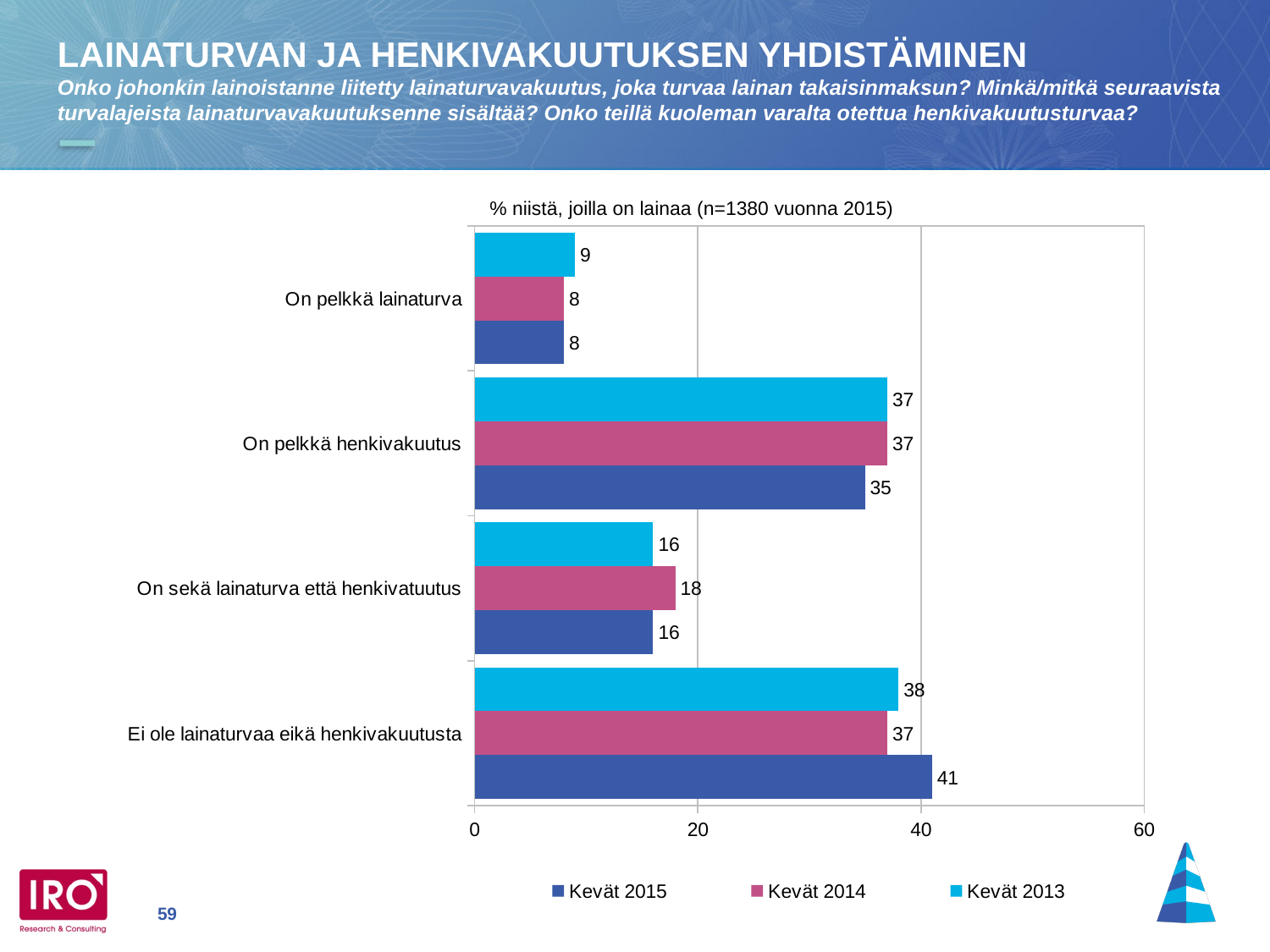
Is the Kevät 2015 value for 'On pelkkä henkivakuutus' greater or less than 20? greater Which category has the highest value for Kevät 2015? Ei ole lainaturvaa eikä henkivakuutusta What is the subtitle printed above the chart? % niistä, joilla on lainaa (n=1380 vuonna 2015) What kind of chart is shown on the slide? bar chart What is the value for Kevät 2015 in the category 'Ei ole lainaturvaa eikä henkivakuutusta'? 41 Which category has the lowest value for Kevät 2014? On pelkkä lainaturva How many categories are shown on the chart? 4 What is the value for Kevät 2014 in the category 'On sekä lainaturva että henkivatuutus'? 18 What is the difference between the Kevät 2015 and Kevät 2014 values for 'Ei ole lainaturvaa eikä henkivakuutusta'? 4 How many series does the legend list? 3 For 'On pelkkä henkivakuutus', which is larger: the Kevät 2013 value or the Kevät 2015 value? Kevät 2013 What is the value for Kevät 2013 in the category 'On pelkkä lainaturva'? 9